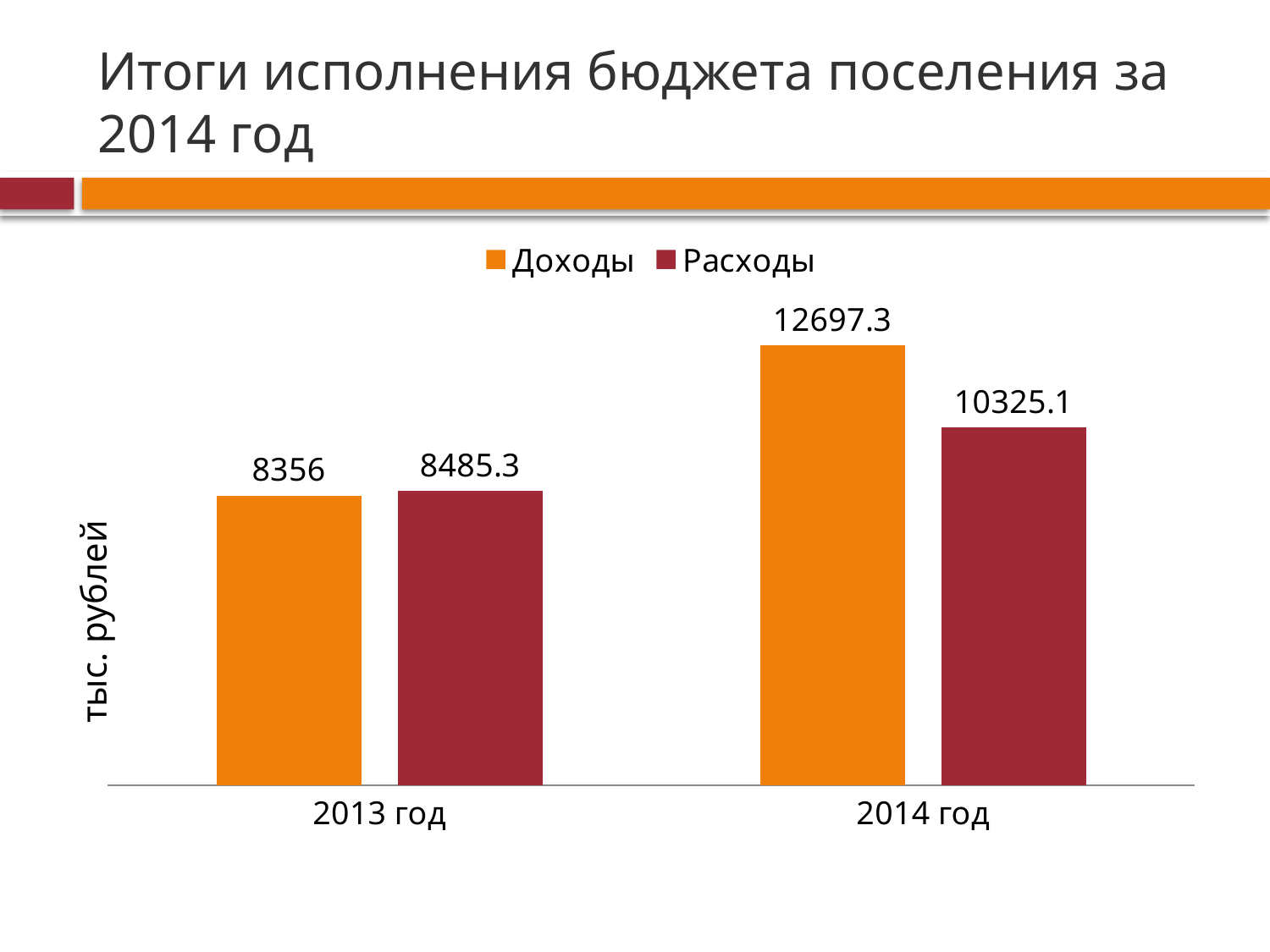
What is the value of Доходы for 2014 год? 12697.3 How many series does the legend list? 2 What type of chart is shown on the slide? Bar chart What is the value of Доходы for 2013 год? 8356 Which bar has the highest value on the chart? Доходы, 2014 год For 2013 год, which is larger: Доходы or Расходы? Расходы By how much did Доходы increase from 2013 год to 2014 год? 4341.3 What is the label of the vertical axis? тыс. рублей What is the value of Расходы for 2014 год? 10325.1 What is the value of Расходы for 2013 год? 8485.3 Which bar has the lowest value on the chart? Доходы, 2013 год What is the difference between Доходы and Расходы for 2014 год? 2372.2